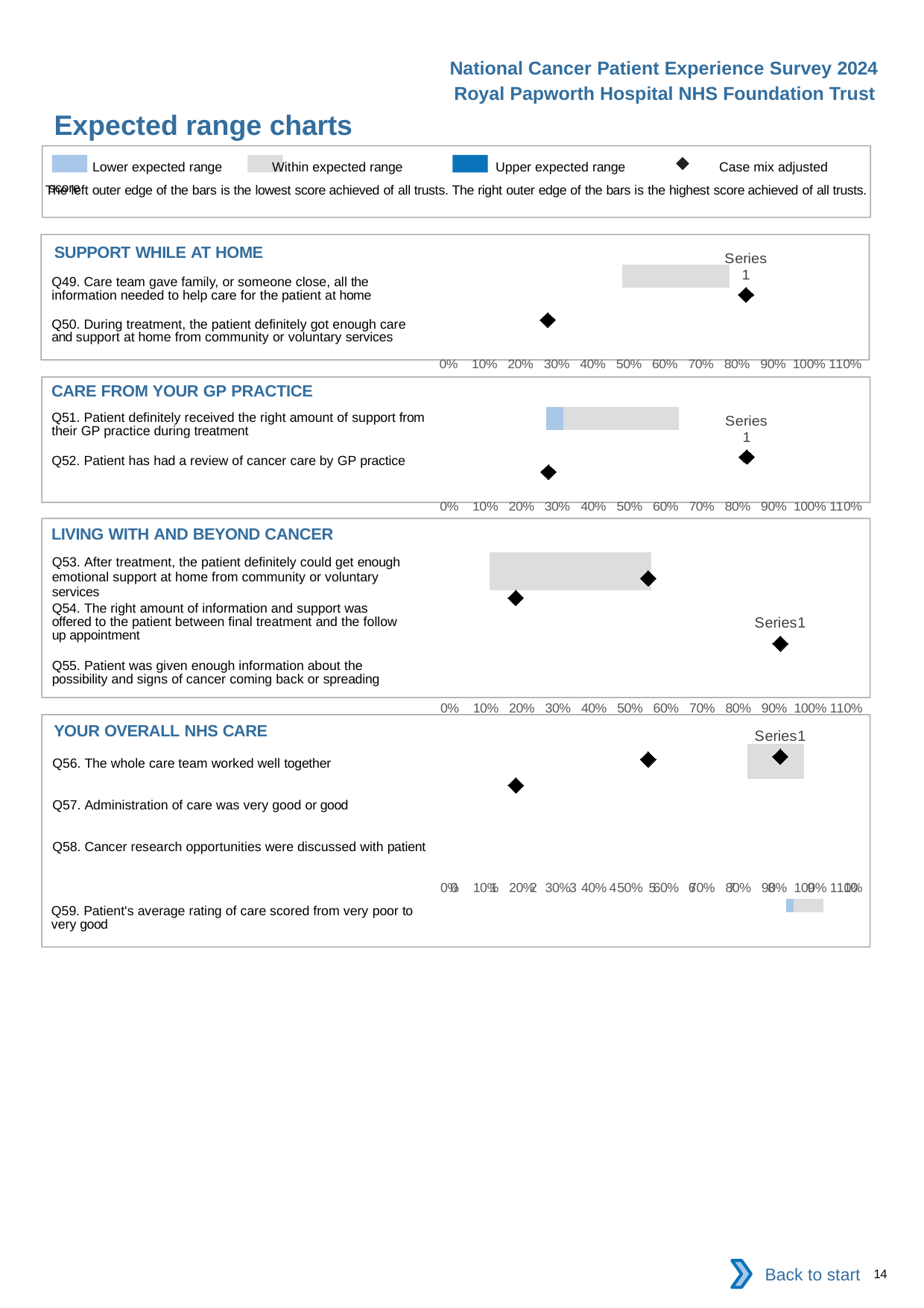
What kind of chart is used in the 'SUPPORT WHILE AT HOME' section? bar chart What is the highest percentage tick shown on the x axis of the 'CARE FROM YOUR GP PRACTICE' chart? 110% How many questions are listed in the 'LIVING WITH AND BEYOND CANCER' chart? 3 How many entries does the legend at the top of the slide list? 4 How many questions are listed in the 'YOUR OVERALL NHS CARE' chart? 4 In the 'SUPPORT WHILE AT HOME' chart, is the case mix adjusted score for Q49 greater or less than 70%? greater In the 'SUPPORT WHILE AT HOME' chart, which has the higher case mix adjusted score, Q49 or Q50? Q49 In the 'SUPPORT WHILE AT HOME' chart, is the case mix adjusted score for Q50 greater or less than 40%? less